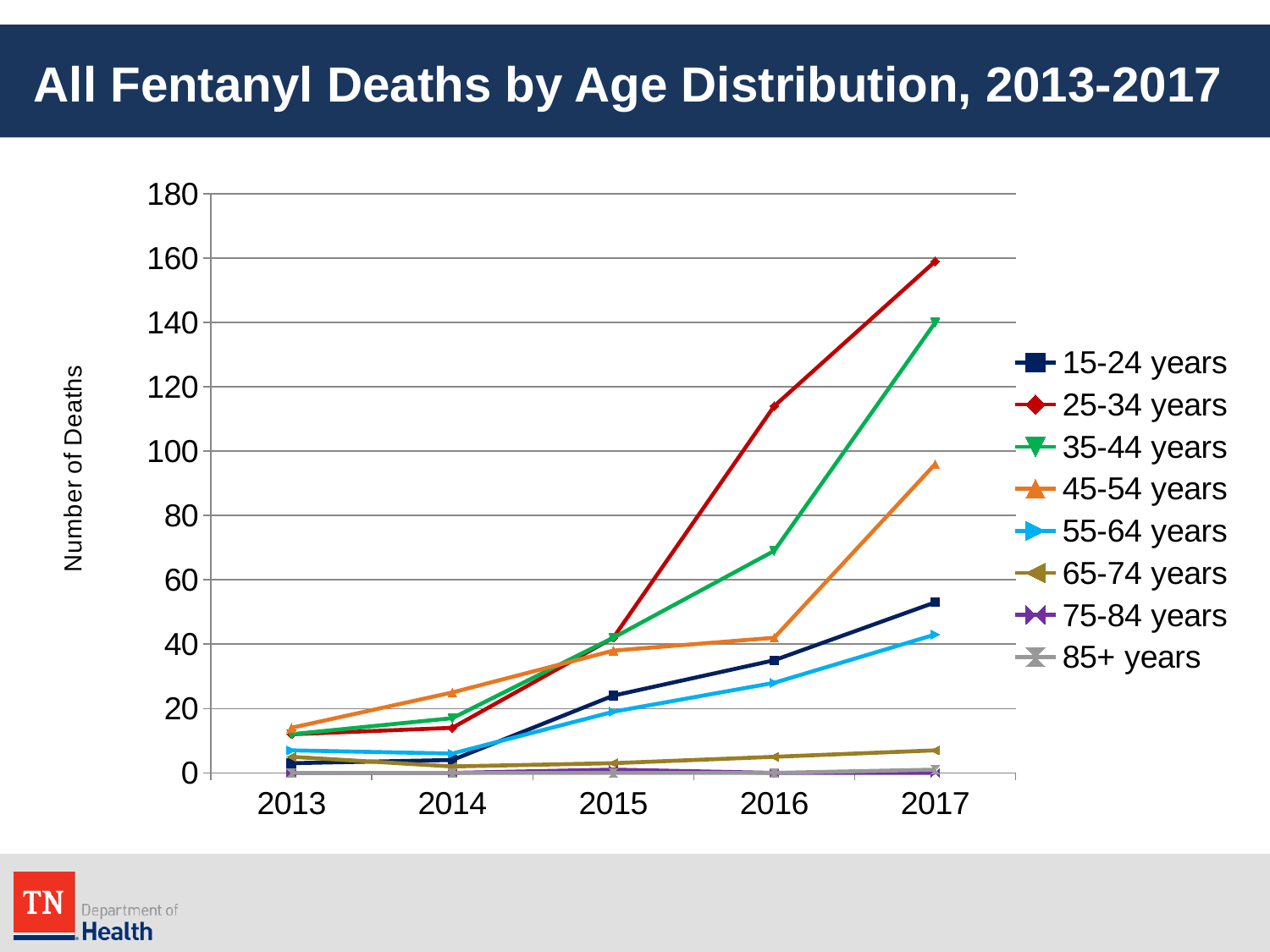
What is the label of the y axis? Number of Deaths What kind of chart is shown on the slide? line chart Which age group has the highest number of deaths in 2017? 25-34 years Is the value for 45-54 years in 2017 greater or less than 100? less What is the title of the chart? All Fentanyl Deaths by Age Distribution, 2013-2017 How many years are plotted along the x axis? 5 Is the value for 35-44 years in 2016 greater or less than 80? less How many series does the legend list? 8 Do the deaths for 25-34 years rise or fall from 2013 to 2017? rise Which is larger in 2017, the value for 25-34 years or the value for 45-54 years? 25-34 years Is the value for 25-34 years in 2016 greater or less than 100? greater